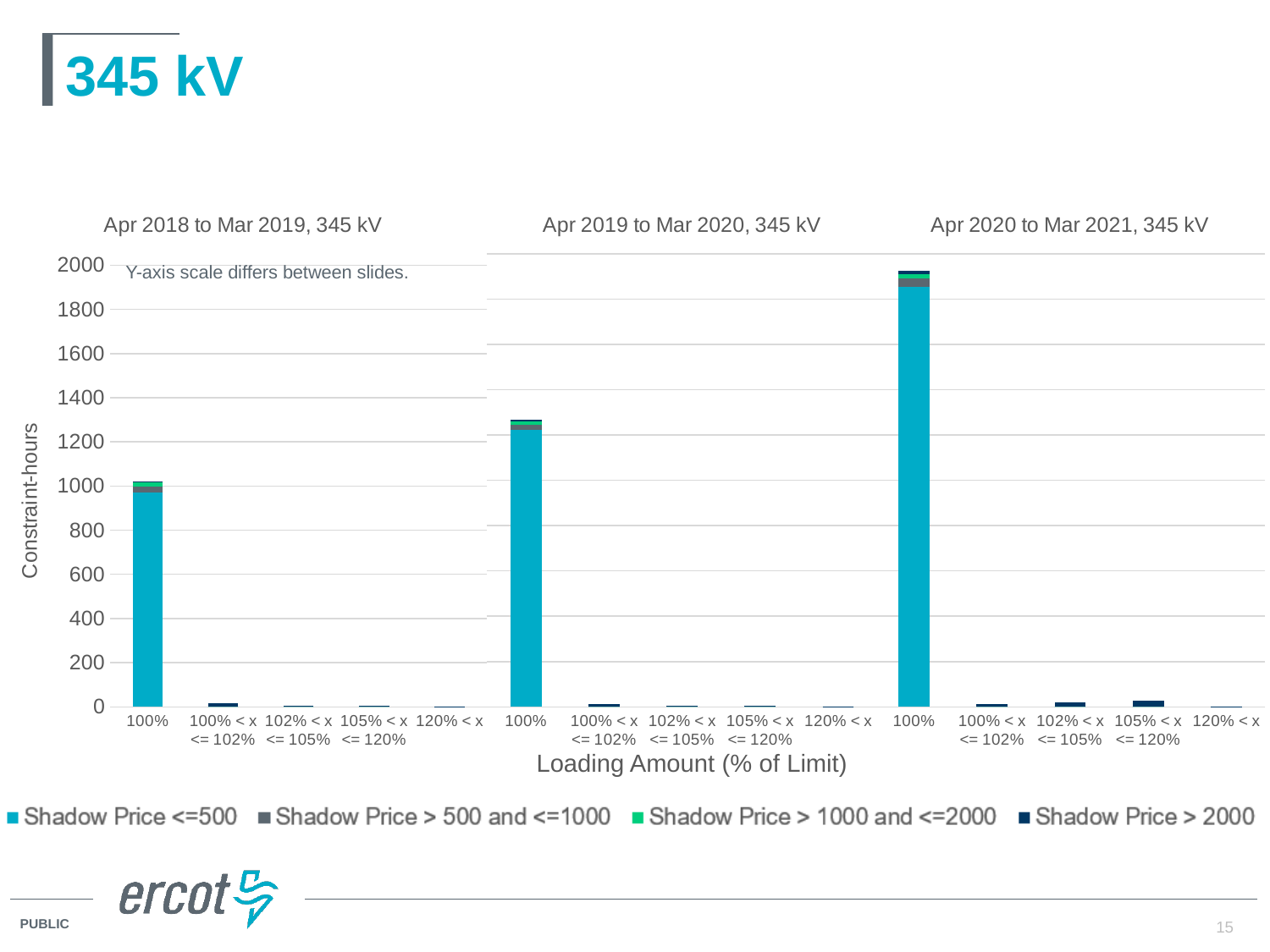
In the 'Apr 2018 to Mar 2019, 345 kV' chart, is the total for the 100% category greater or less than 800? greater In the 'Apr 2020 to Mar 2021, 345 kV' chart, which loading amount category has the highest total constraint-hours? 100% What kind of chart is shown on the slide? Stacked bar chart Which chart has the taller bar for the 100% category: 'Apr 2018 to Mar 2019, 345 kV' or 'Apr 2020 to Mar 2021, 345 kV'? Apr 2020 to Mar 2021, 345 kV In the 'Apr 2020 to Mar 2021, 345 kV' chart, is the total for the 100% category greater or less than 1800? greater In the 'Apr 2018 to Mar 2019, 345 kV' chart, how many loading amount categories are shown on the x axis? 5 What is the title of the y axis? Constraint-hours In the 'Apr 2018 to Mar 2019, 345 kV' chart, is the total for the 100% category greater or less than 1200? less What is the title of the x axis? Loading Amount (% of Limit) How many series does the legend list? 4 In the 'Apr 2018 to Mar 2019, 345 kV' chart, which loading amount category has the highest total constraint-hours? 100%